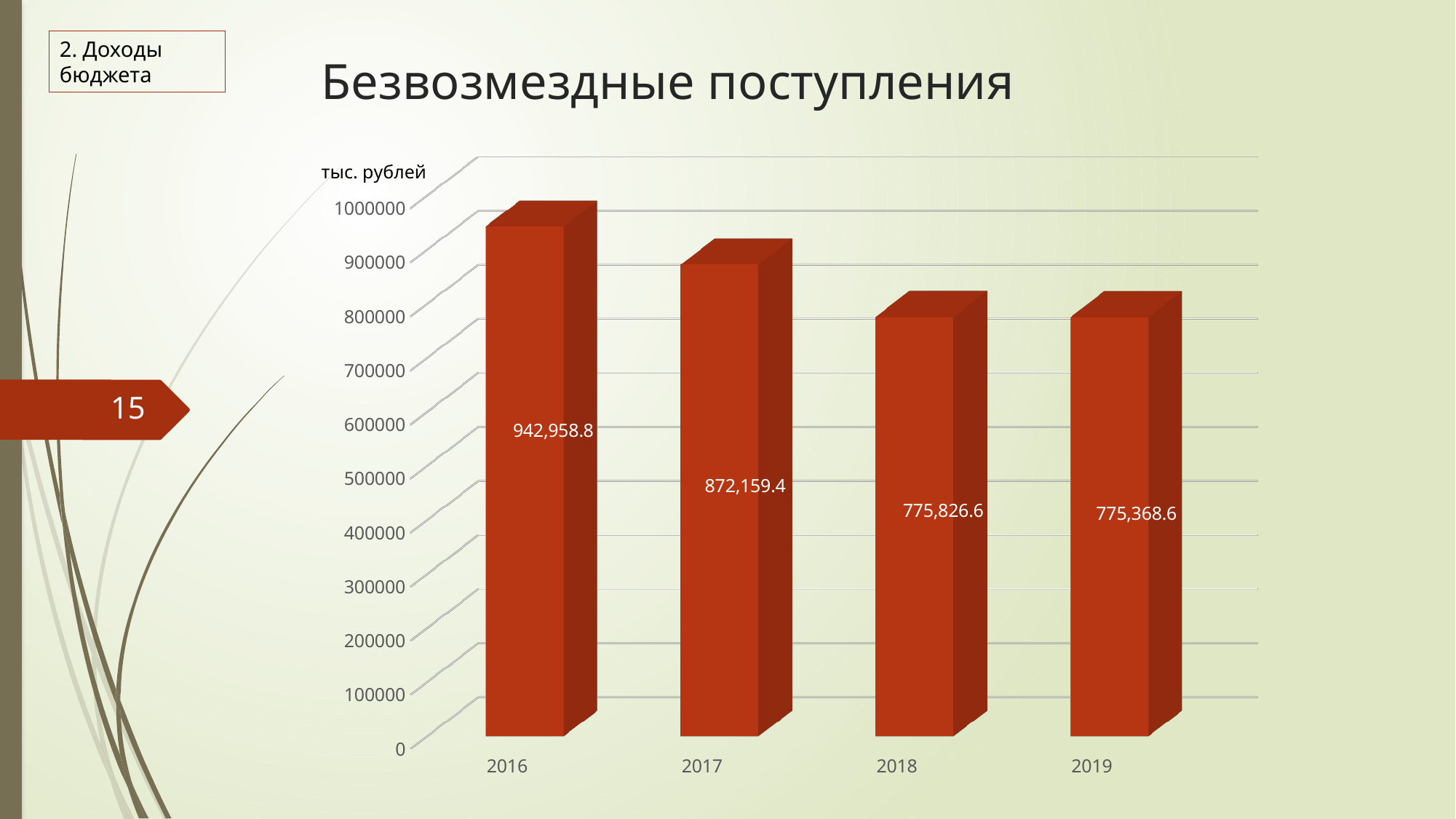
Which is larger, the value for 2016 or the value for 2017? 2016 What is the value for 2017? 872,159.4 What is the value for 2019? 775,368.6 What is the value for 2016? 942,958.8 Do the values rise or fall from 2016 to 2019? Fall Which year has the lowest value? 2019 Which year has the highest value? 2016 What is the difference between the values for 2018 and 2019? 458.0 What kind of chart is shown on the slide? Bar chart How many years are shown on the x axis? 4 What is the value for 2018? 775,826.6 What is the difference between the values for 2016 and 2017? 70,799.4